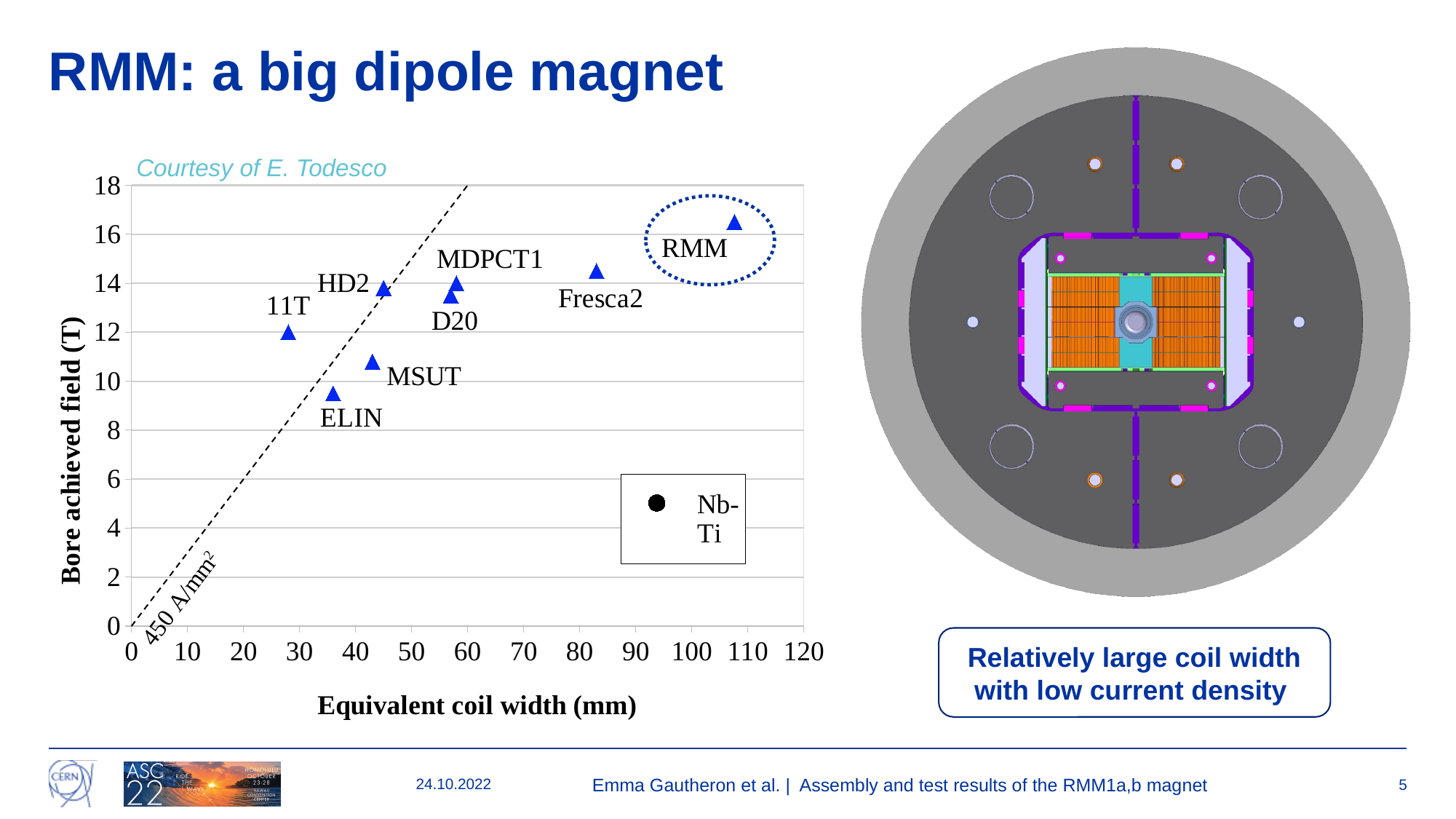
Which magnet has the largest equivalent coil width? RMM Is the bore achieved field for ELIN greater or less than 10 T? less What is the title of the x axis of the chart? Equivalent coil width (mm) Is the bore achieved field for RMM greater or less than 16 T? greater Is the equivalent coil width for RMM greater or less than 100 mm? greater Which magnet has the lowest bore achieved field? ELIN Which magnet has the highest bore achieved field? RMM Which has the larger equivalent coil width, Fresca2 or HD2? Fresca2 What kind of chart is shown on the slide? scatter chart Which magnet has the smallest equivalent coil width? 11T Which has the higher bore achieved field, MSUT or ELIN? MSUT How many labeled magnets are plotted on the chart? 8